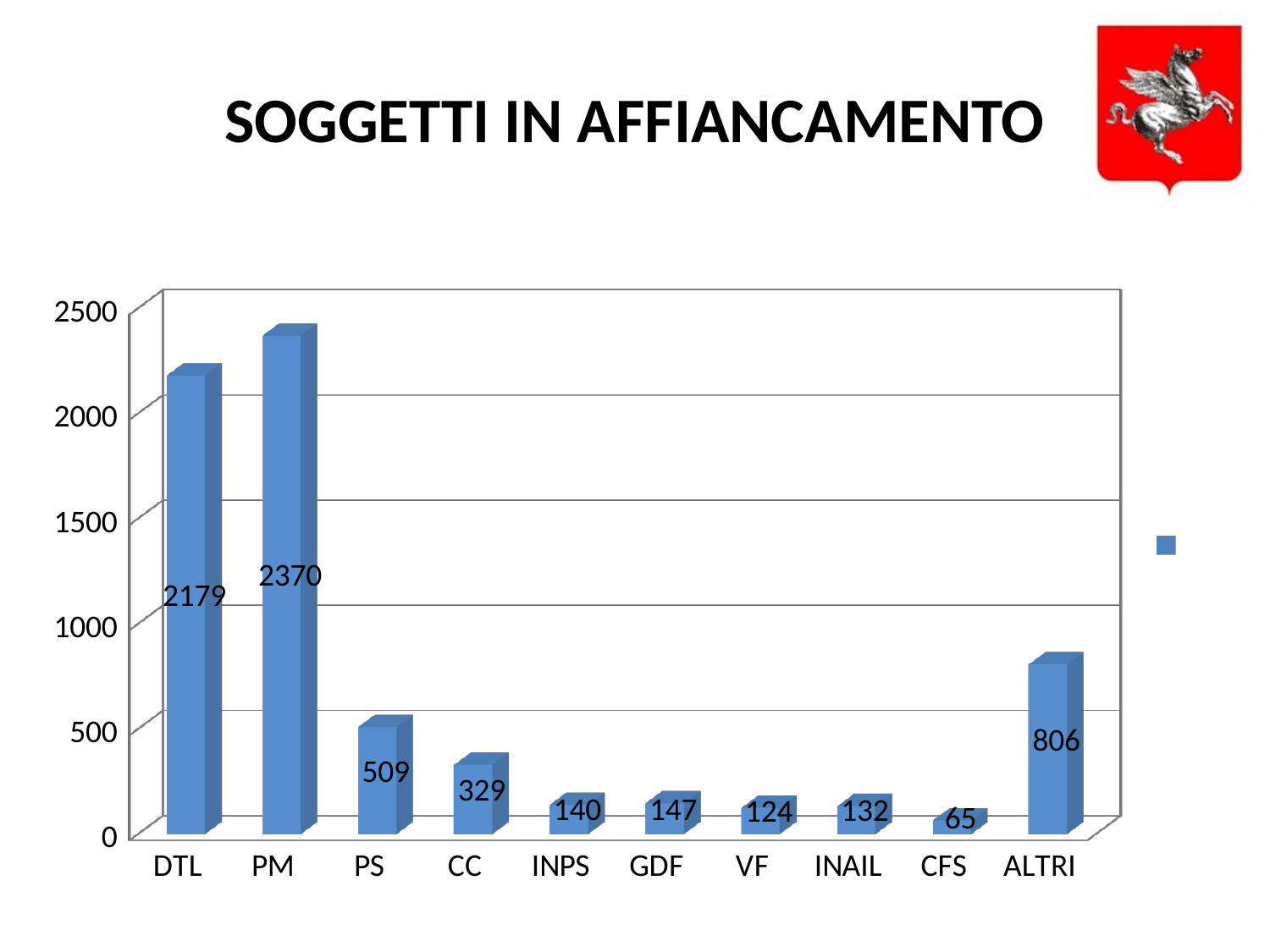
What is the value for PM? 2370 What is the difference between the values for PM and DTL? 191 Is the value for ALTRI greater or less than 1000? less What is the title of the slide? SOGGETTI IN AFFIANCAMENTO What is the value for ALTRI? 806 Which category has the highest value? PM What is the difference between the values for PS and CC? 180 Which category has the lowest value? CFS What is the value for CC? 329 Which is larger, the value for GDF or the value for INPS? GDF How many categories are shown on the x axis? 10 What kind of chart is shown on the slide? bar chart